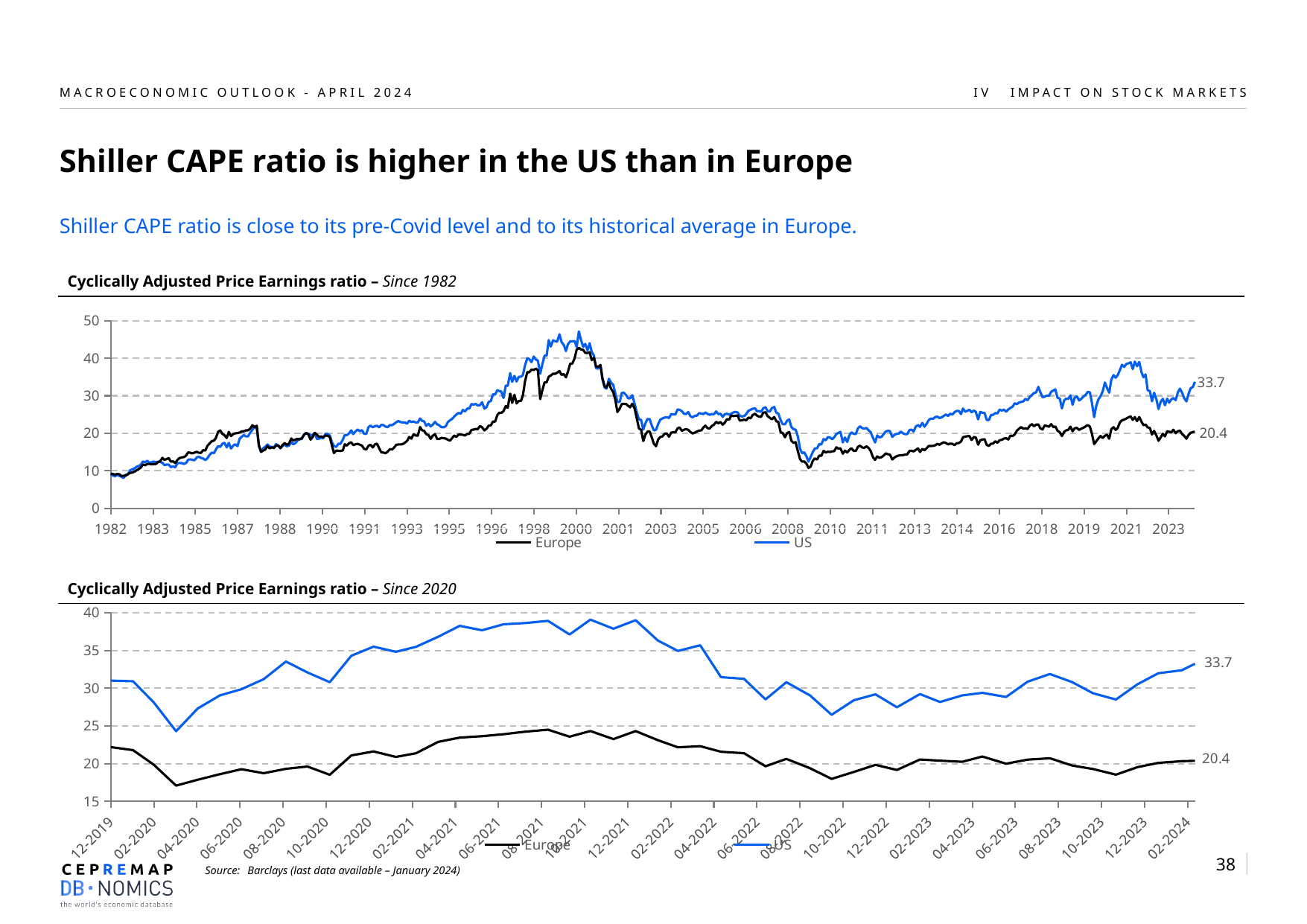
On the 'Since 1982' chart, what is the difference between the latest US value and the latest Europe value? 13.3 On the 'Since 2020' chart, is the US value in 04-2020 greater or less than 30? less What kind of chart is the 'Since 2020' chart? Line chart On the 'Since 2020' chart, does the US series rise or fall between 12-2021 and 10-2022? Fall On the 'Since 1982' chart, is the US value around 2000 greater or less than 40? greater On the 'Since 2020' chart, which series has the higher latest value, US or Europe? US On the 'Since 1982' chart, what is the latest value shown for the US series? 33.7 How many series does the legend of the 'Since 1982' chart list? 2 On the 'Since 2020' chart, is the Europe value in 04-2020 greater or less than 20? less On the 'Since 1982' chart, what is the latest value shown for the Europe series? 20.4 What is the source cited for the charts? Barclays (last data available – January 2024) Which colour is used for the US series on both charts? Blue